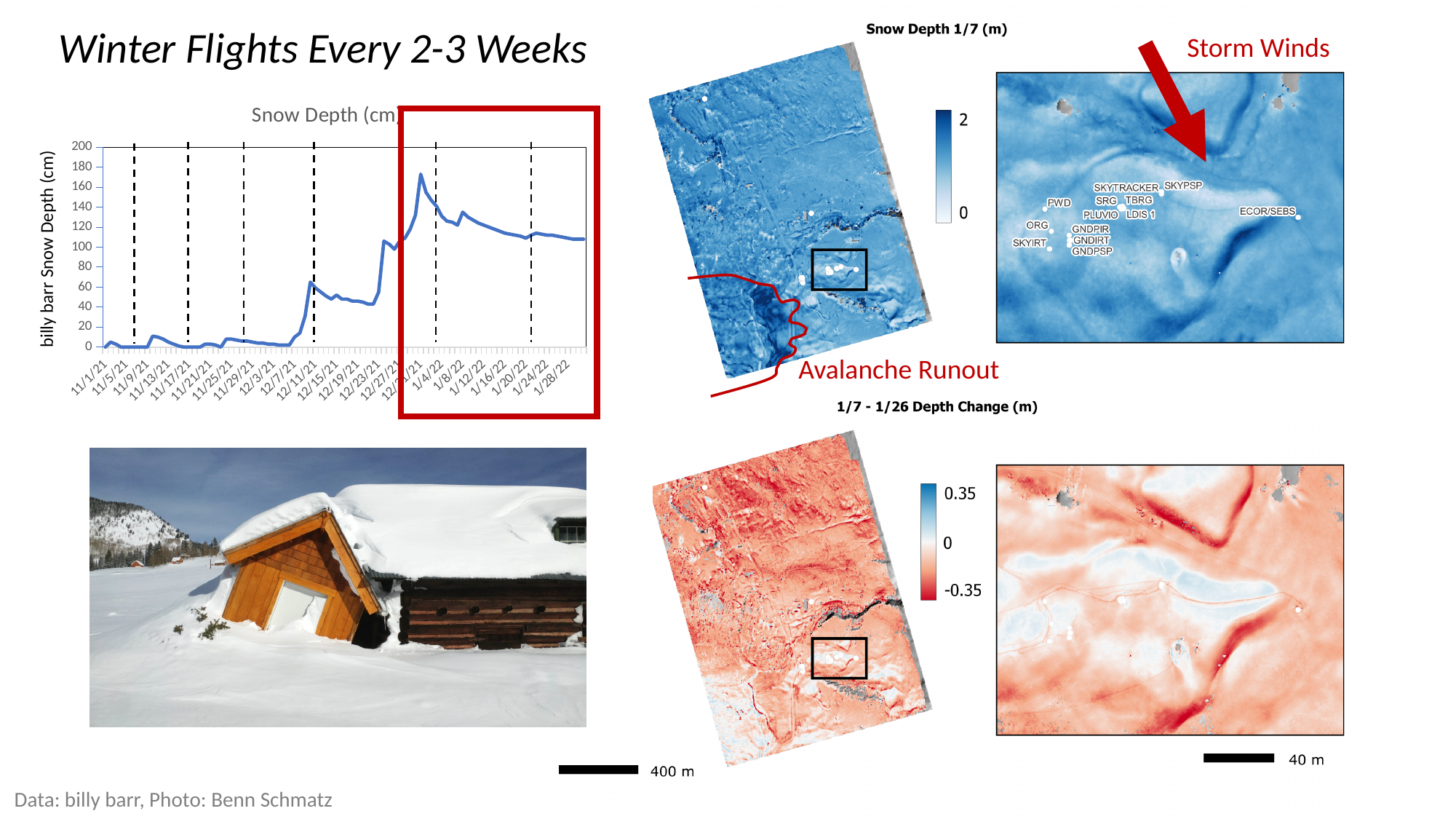
On the Snow Depth (cm) chart, is the snow depth on 1/28/22 greater or less than 80? greater On the Snow Depth (cm) chart, which date has the larger snow depth, 11/1/21 or 1/28/22? 1/28/22 On the Snow Depth (cm) chart, does the snow depth rise or fall between 1/4/22 and 1/28/22? fall On the Snow Depth (cm) chart, what is the highest value shown on the y axis? 200 On the Snow Depth (cm) chart, is the snow depth on 11/25/21 greater or less than 40? less On the Snow Depth (cm) chart, is the snow depth on 12/11/21 greater or less than 40? greater On the Snow Depth (cm) chart, what is the label of the y axis? billy barr Snow Depth (cm) What kind of chart is the Snow Depth (cm) chart on the left of the slide? line chart How many data series are plotted on the Snow Depth (cm) chart? 1 On the Snow Depth (cm) chart, does the snow depth rise or fall between 12/3/21 and 12/11/21? rise